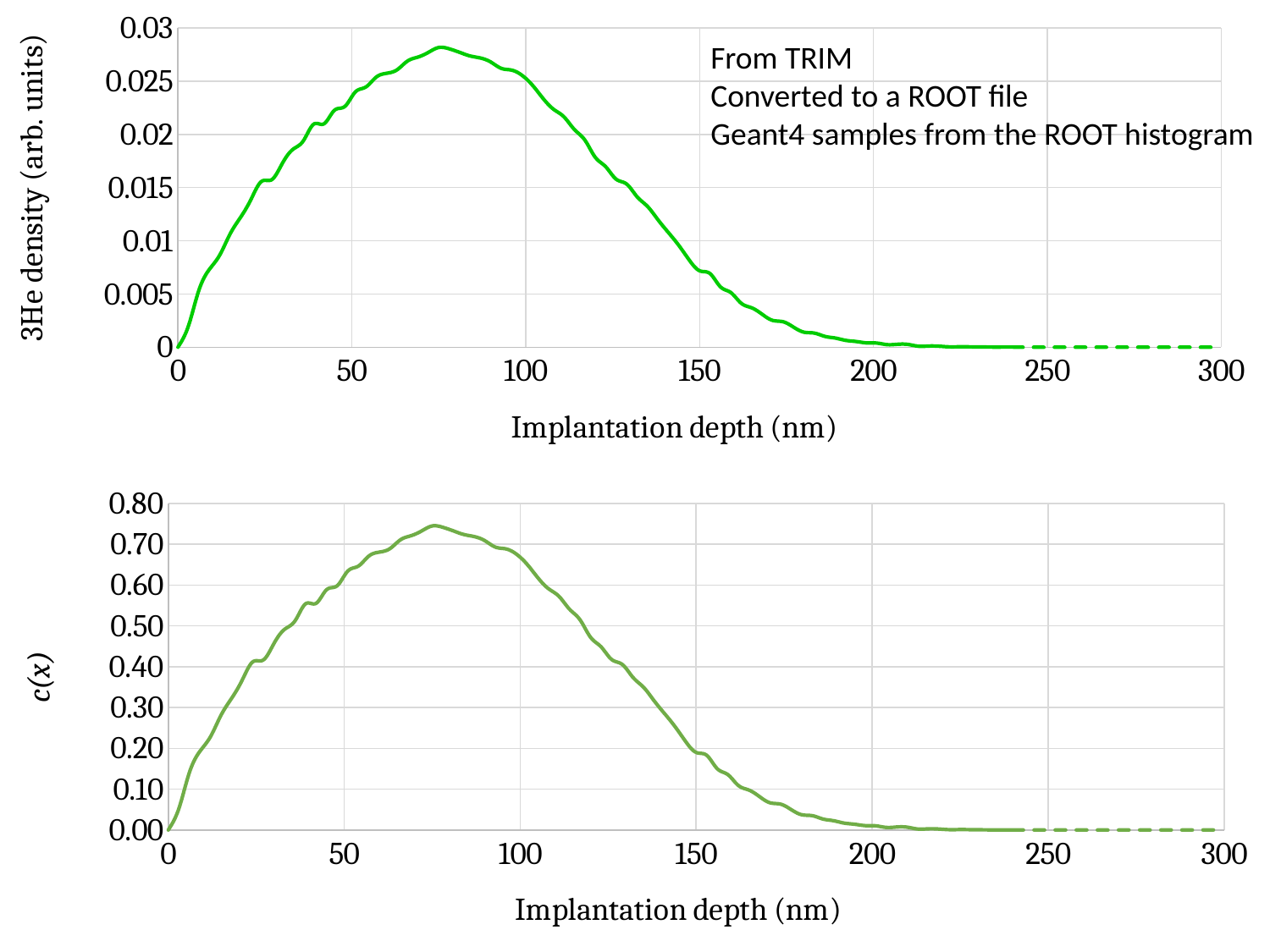
What is the x-axis label of the top chart? Implantation depth (nm) In the top chart, is the peak 3He density greater or less than 0.03? less In the top chart, is the 3He density at an implantation depth of 150 nm greater or less than 0.01? less In the top chart, does the 3He density rise or fall as the implantation depth increases from 100 nm to 200 nm? fall What is the y-axis label of the bottom chart? c(x) In the top chart, is the 3He density at an implantation depth of 50 nm greater or less than 0.02? greater In the bottom chart, does c(x) rise or fall as the implantation depth increases from 0 nm to 50 nm? rise What kind of chart is the bottom chart on the slide? line chart What kind of chart is the top chart on the slide? line chart